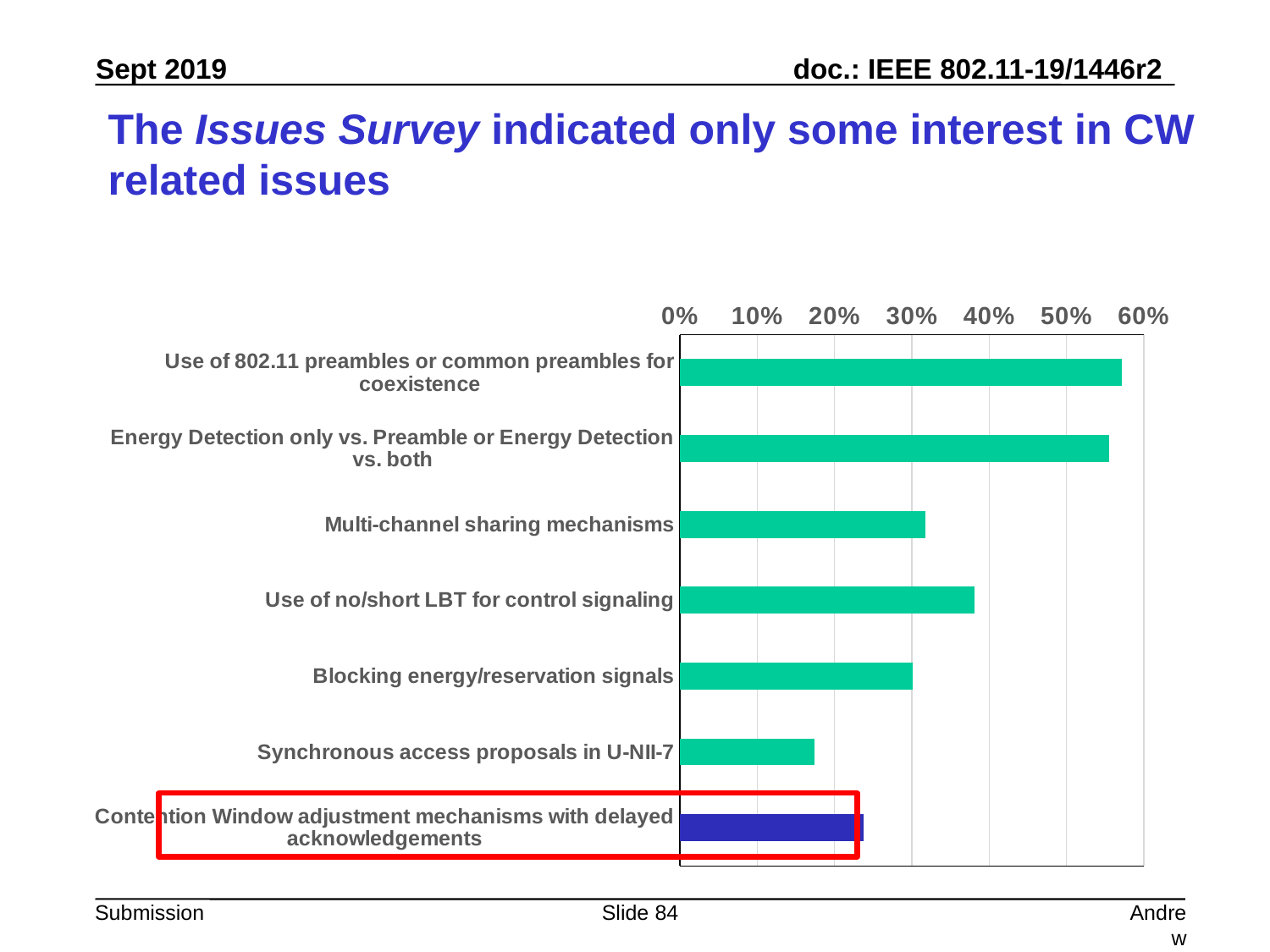
Is the value for "Use of no/short LBT for control signaling" greater or less than 40%? less What is the highest percentage tick shown on the chart's axis? 60% Which category's bar is coloured differently (blue) from the others and outlined with a red box? Contention Window adjustment mechanisms with delayed acknowledgements Is the value for "Energy Detection only vs. Preamble or Energy Detection vs. both" greater or less than 50%? greater Is the value for "Synchronous access proposals in U-NII-7" greater or less than 20%? less Which category has the lowest value in the chart? Synchronous access proposals in U-NII-7 Which is larger: the value for "Use of no/short LBT for control signaling" or for "Multi-channel sharing mechanisms"? Use of no/short LBT for control signaling Which is larger: the value for "Blocking energy/reservation signals" or for "Synchronous access proposals in U-NII-7"? Blocking energy/reservation signals What kind of chart is shown on the slide? bar chart How many categories are plotted in the chart? 7